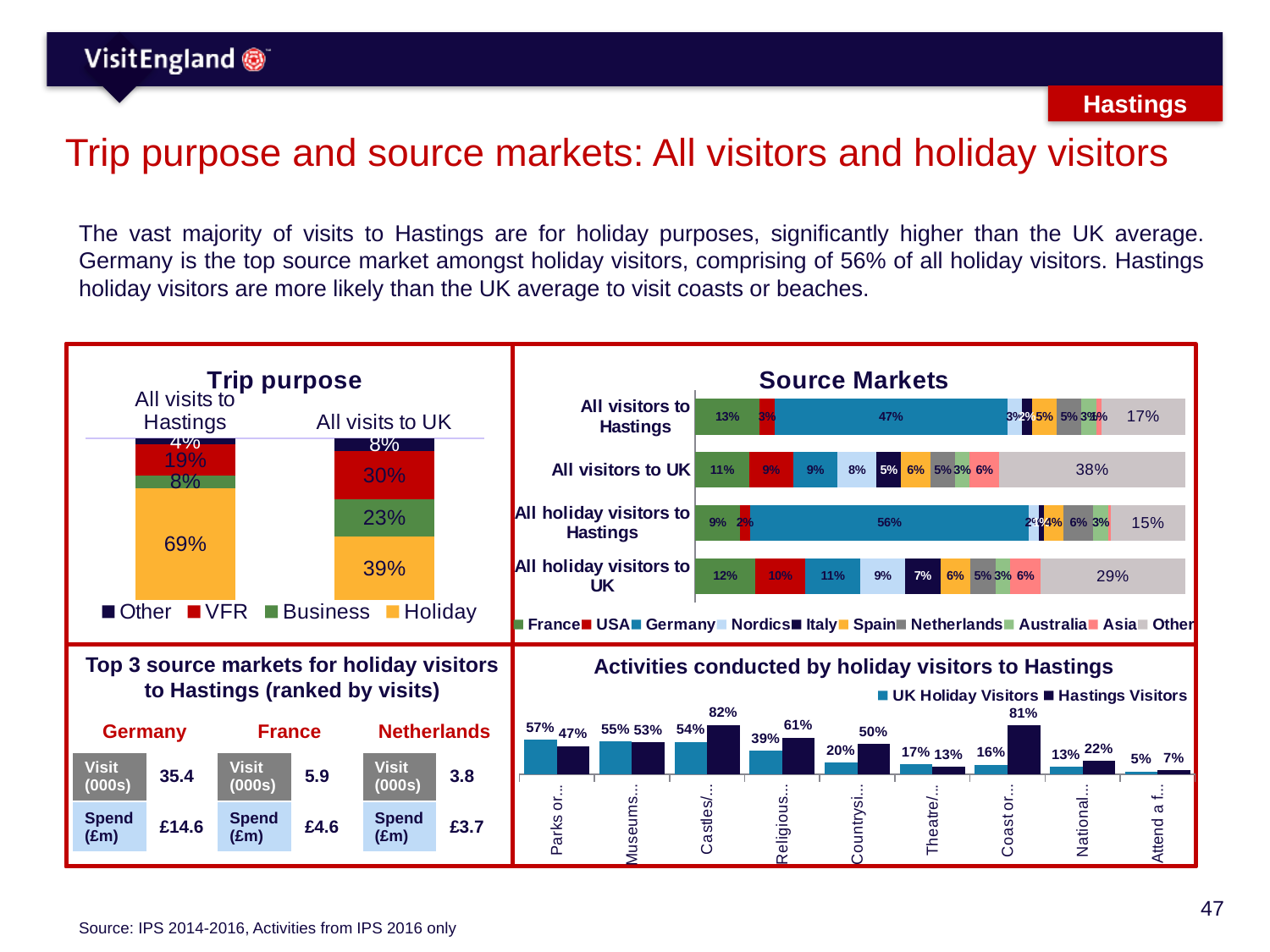
In the Trip purpose chart, what share of all visits to Hastings are for Holiday? 69% In the Source Markets chart, what share of all visitors to UK fall in the Other category? 38% In the Activities conducted by holiday visitors to Hastings chart, what is the difference between Hastings Visitors and UK Holiday Visitors for Countryside? 30 percentage points In the Source Markets chart, what share of all holiday visitors to Hastings come from Germany? 56% In the Activities conducted by holiday visitors to Hastings chart, which is larger for Coast: UK Holiday Visitors or Hastings Visitors? Hastings Visitors In the Activities conducted by holiday visitors to Hastings chart, what is the value for Hastings Visitors for Castles? 82% In the Source Markets chart, which source market is the largest for all visitors to Hastings? Germany How many series does the legend of the Trip purpose chart list? 4 How many series does the legend of the Source Markets chart list? 10 In the Trip purpose chart, what share of all visits to UK are VFR? 30% In the Trip purpose chart, what is the difference between the Holiday share for all visits to Hastings and for all visits to UK? 39 percentage points What kind of chart is the Source Markets chart? Stacked bar chart